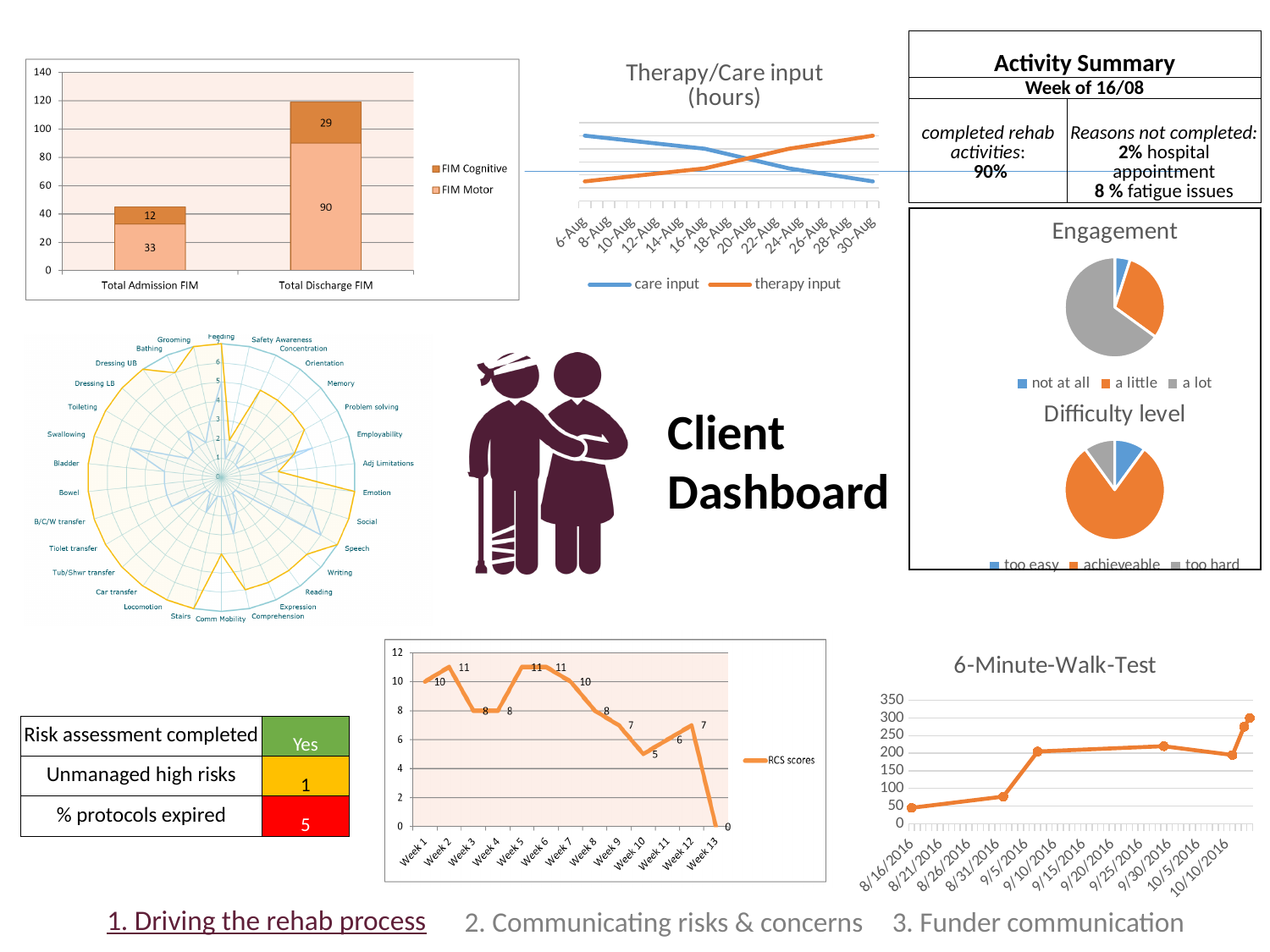
In the 6-Minute-Walk-Test chart, is the value for 8/16/2016 greater or less than 100? less In the FIM bar chart at the top left, what is the FIM Cognitive value for Total Admission FIM? 12 In the FIM bar chart at the top left, what is the total of the stacked bar for Total Discharge FIM? 119 In the RCS scores chart at the bottom centre, how many weeks are plotted on the x axis? 13 In the 6-Minute-Walk-Test chart, do the values generally rise or fall from 8/16/2016 to 10/10/2016? rise In the FIM bar chart at the top left, how many series does the legend list? 2 In the RCS scores chart at the bottom centre, what is the RCS score for Week 10? 5 In the FIM bar chart at the top left, what is the total of the stacked bar for Total Admission FIM? 45 In the RCS scores chart at the bottom centre, which is larger, the score for Week 2 or the score for Week 9? Week 2 In the FIM bar chart at the top left, what is the FIM Motor value for Total Discharge FIM? 90 In the FIM bar chart at the top left, what is the difference between the FIM Motor values for Total Discharge FIM and Total Admission FIM? 57 In the RCS scores chart at the bottom centre, what is the RCS score for Week 13? 0